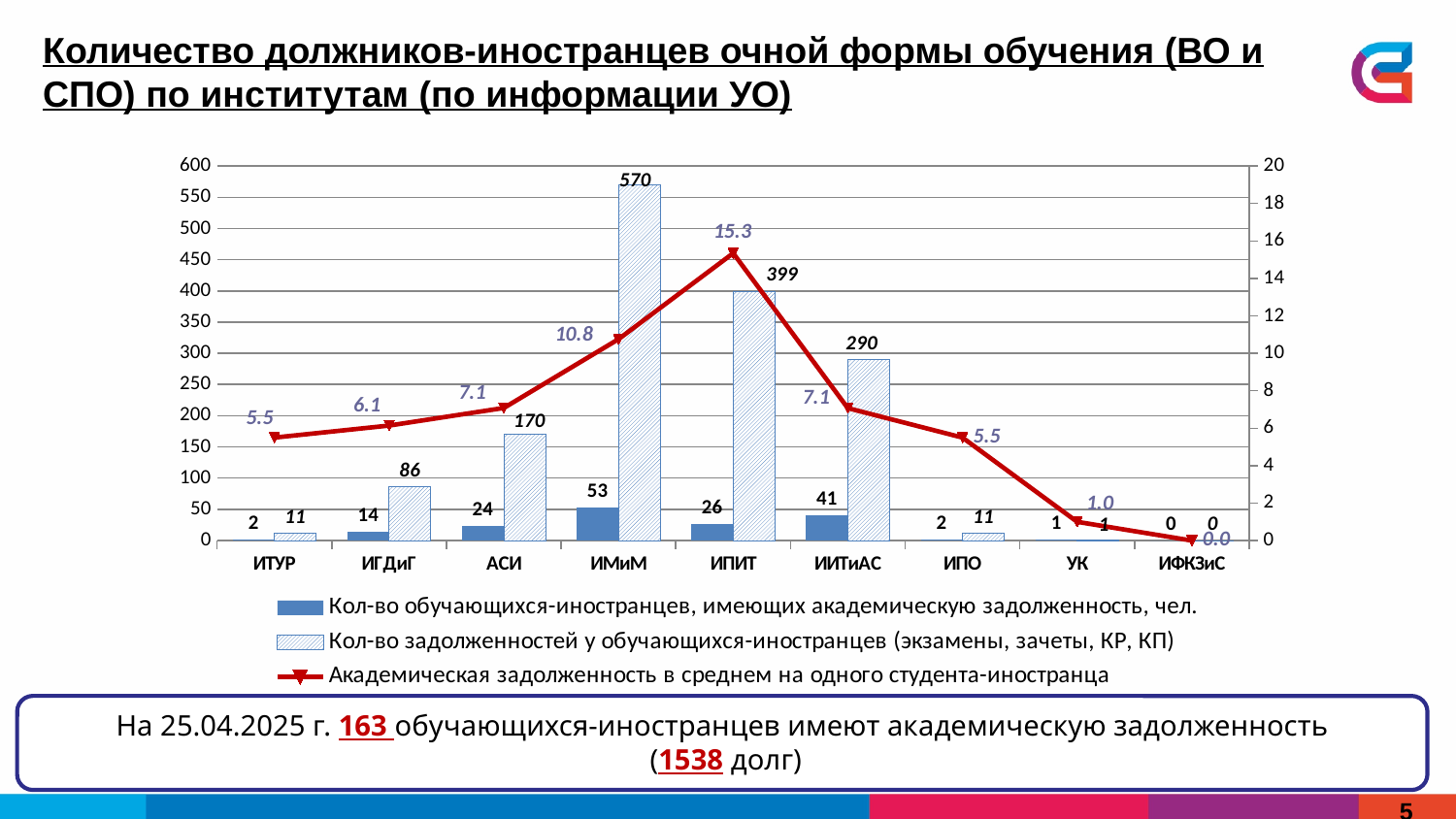
What is the difference between the number of debts for ИПИТ and ИИТиАС? 109 Which has more foreign students with academic debt, ИМиМ or ИПИТ? ИМиМ Which institute has the highest average academic debt per foreign student? ИПИТ Which institute has the lowest number of foreign students with academic debt? ИФКЗиС What kind of chart is this? Combined bar and line chart Which institute has the highest number of debts (Кол-во задолженностей)? ИМиМ What is the average academic debt per foreign student (Академическая задолженность в среднем) for ИПИТ? 15.3 What is the difference between the number of debts for АСИ and ИГДиГ? 84 How many institutes are shown on the x axis? 9 How many series does the legend list? 3 How many debts (Кол-во задолженностей) are shown for ИМиМ? 570 What is the number of foreign students with academic debt (Кол-во обучающихся-иностранцев) for ИИТиАС? 41